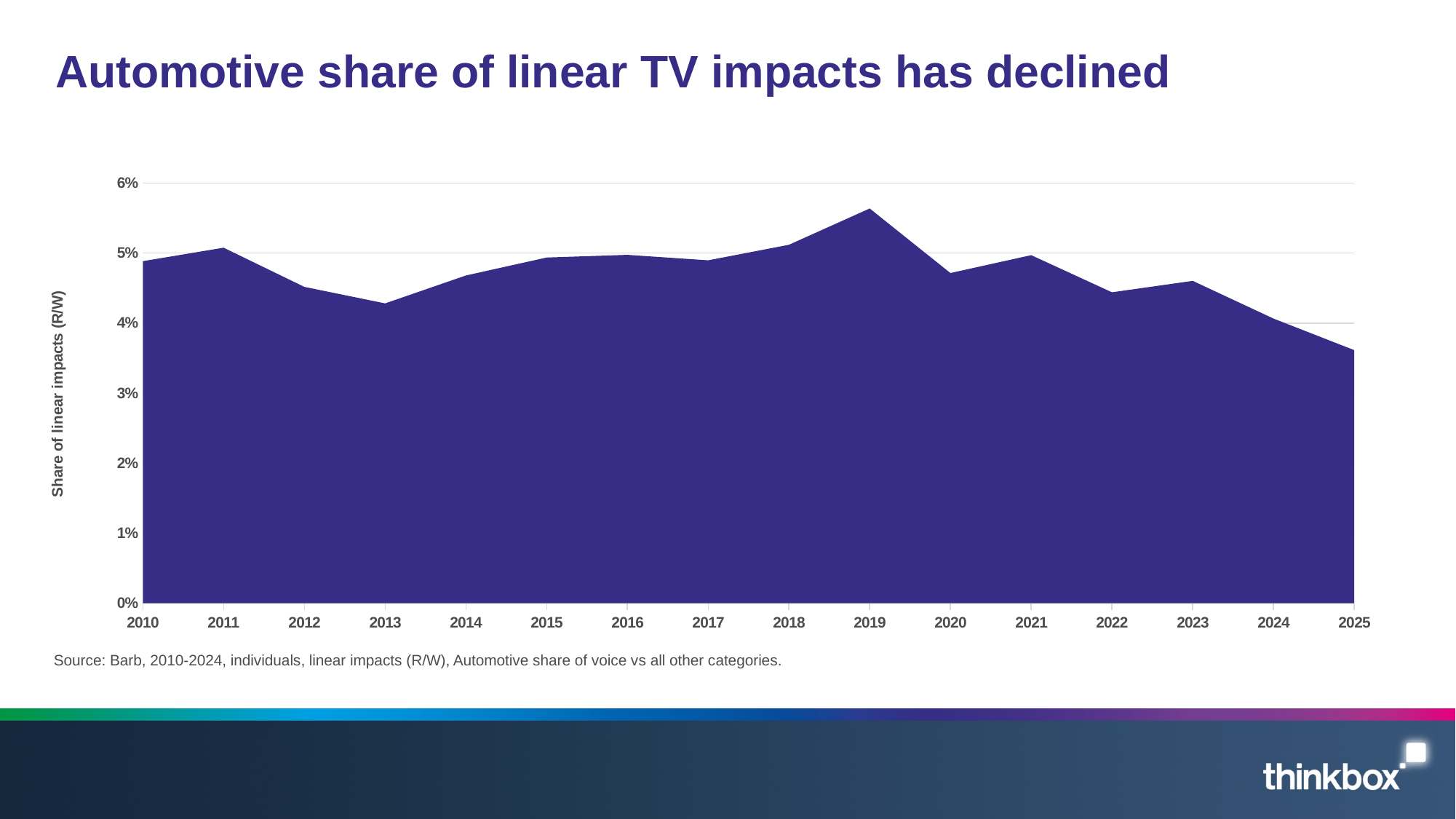
Which year has the larger share of linear impacts, 2010 or 2025? 2010 What kind of chart is shown on the slide? Area chart Is the value for 2013 greater or less than 5%? less Overall, does the automotive share of linear impacts rise or fall from 2010 to 2025? Fall Which year has the lowest automotive share of linear impacts? 2025 Is the value for 2019 greater or less than 5%? greater Is the value for 2022 greater or less than 5%? less Which year has the larger share of linear impacts, 2019 or 2025? 2019 What is the label on the vertical axis of the chart? Share of linear impacts (R/W) Which year has the highest automotive share of linear impacts? 2019 How many years are plotted along the x axis? 16